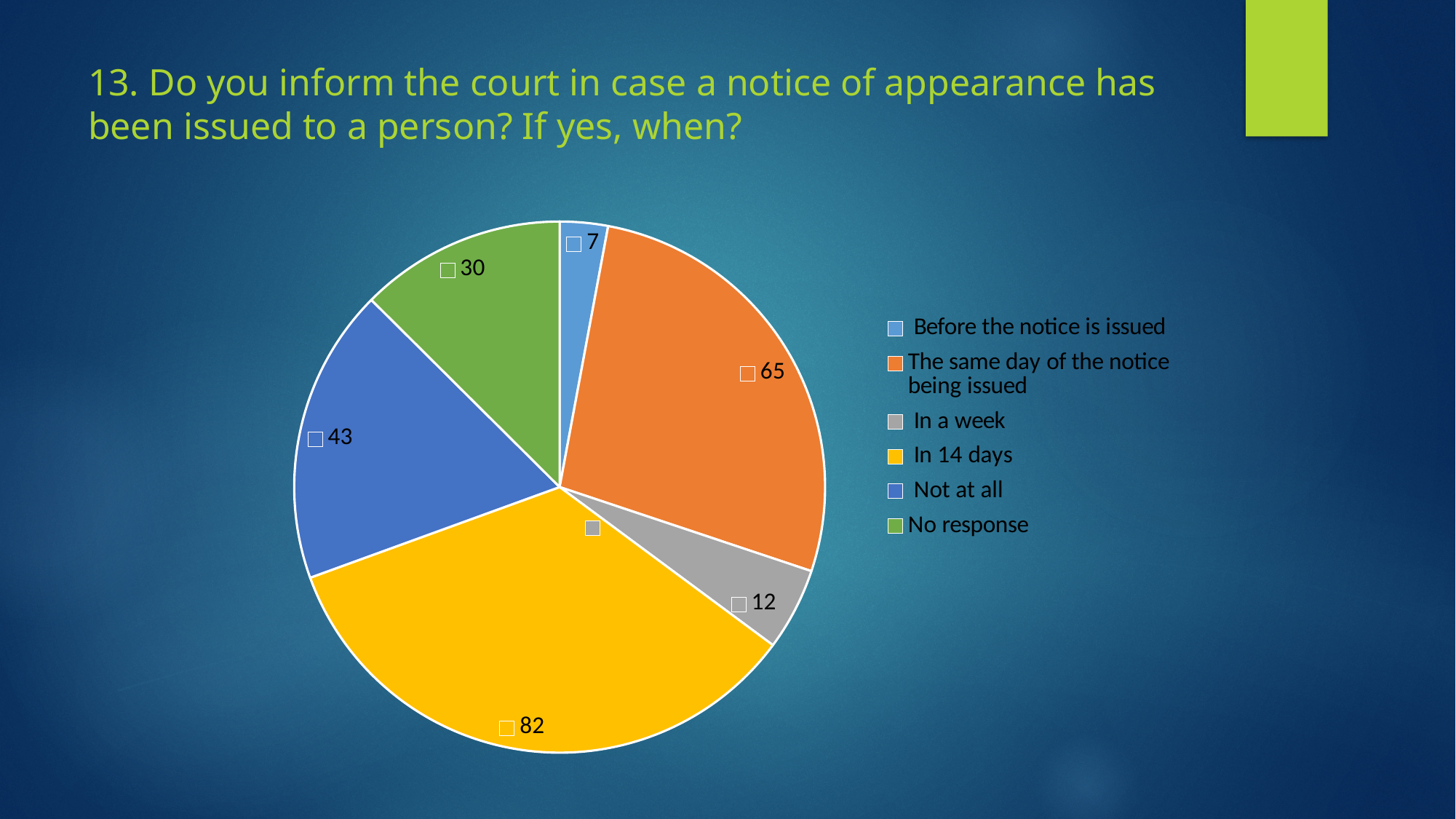
What is the value for "No response"? 30 What is the value for "Before the notice is issued"? 7 What is the value for "In a week"? 12 How many categories does the pie chart show? 6 What is the difference between the values for "In 14 days" and "The same day of the notice being issued"? 17 What kind of chart is shown on the slide? Pie chart What is the value for "Not at all"? 43 Which category has the smallest slice? Before the notice is issued What is the value for "In 14 days"? 82 Which category has the largest slice? In 14 days What is the difference between the values for "Not at all" and "No response"? 13 Which is larger: "The same day of the notice being issued" or "Not at all"? The same day of the notice being issued